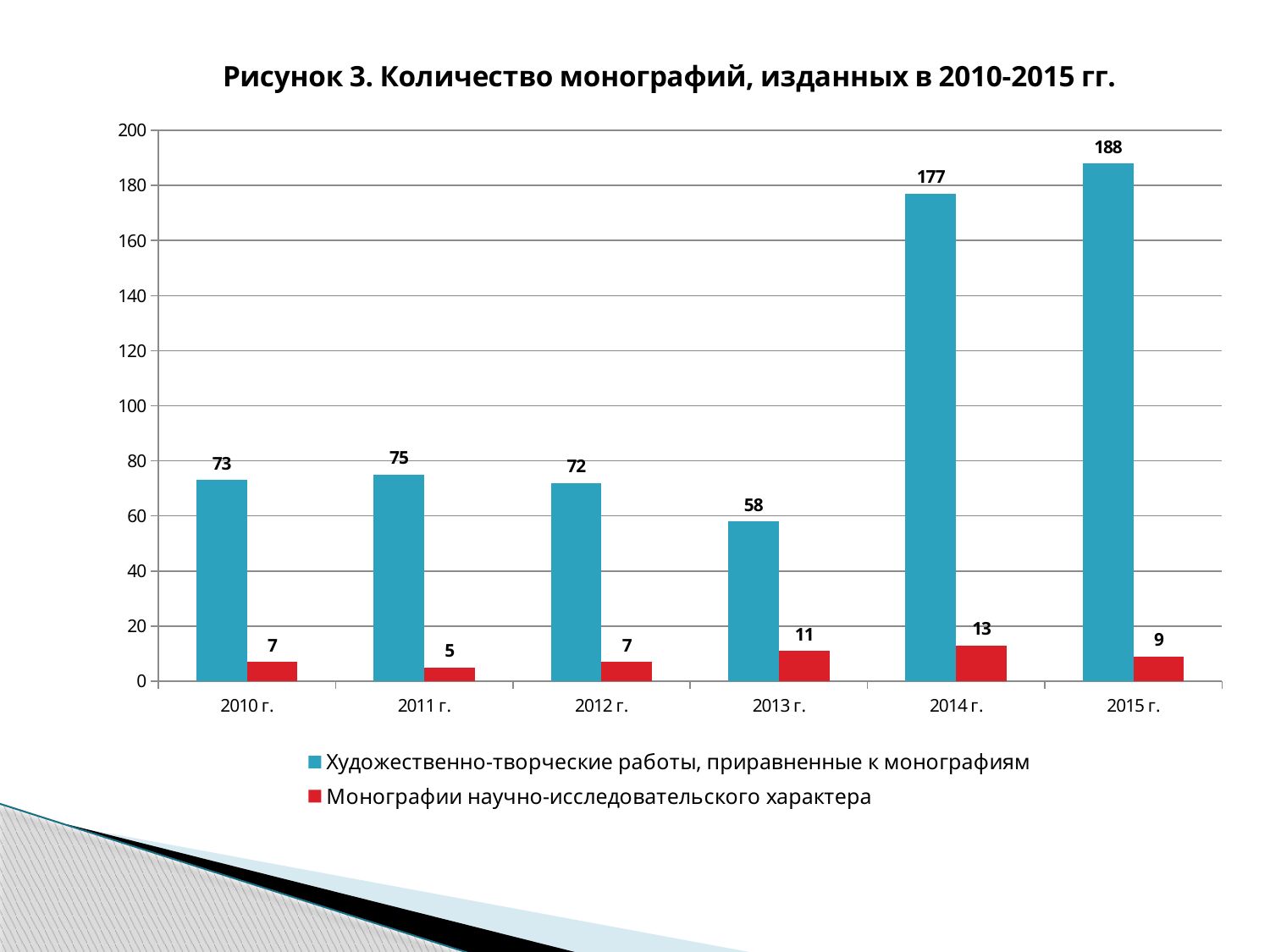
Is the value for 'Художественно-творческие работы, приравненные к монографиям' in 2013 г. greater or less than 60? less How many series does the legend list? 2 Which is larger: the 'Монографии научно-исследовательского характера' value in 2014 г. or in 2015 г.? 2014 г. How many years are shown on the x axis? 6 In which year is the value for 'Монографии научно-исследовательского характера' lowest? 2011 г. What is the value for 'Художественно-творческие работы, приравненные к монографиям' in 2010 г.? 73 In which year is the value for 'Художественно-творческие работы, приравненные к монографиям' highest? 2015 г. What is the value for 'Монографии научно-исследовательского характера' in 2013 г.? 11 What kind of chart is shown on the slide? bar chart What is the value for 'Художественно-творческие работы, приравненные к монографиям' in 2014 г.? 177 What is the difference between the 2015 г. and 2014 г. values for 'Художественно-творческие работы, приравненные к монографиям'? 11 What is the title of the chart? Рисунок 3. Количество монографий, изданных в 2010-2015 гг.